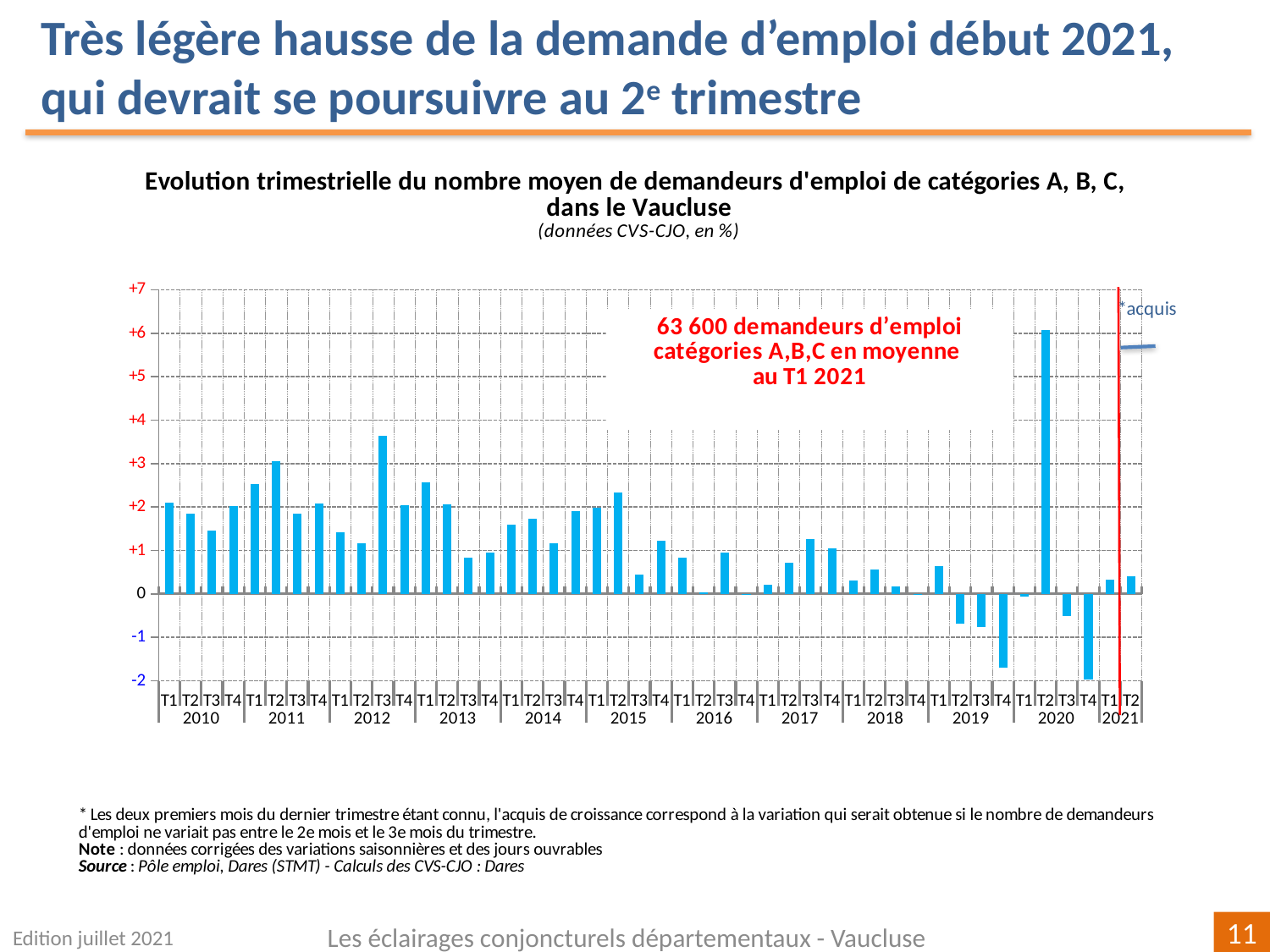
Which is larger, the value for T3 2012 or the value for T2 2011? T3 2012 Is the value for T1 2011 greater or less than +2? greater Is the value for T4 2019 greater or less than -1? less Is the value for T2 2020 greater or less than +5? greater According to the annotation on the chart, how many demandeurs d'emploi catégories A,B,C were there on average in T1 2021? 63 600 What kind of chart is shown on the slide? bar chart Do the values rise or fall from T1 2019 to T4 2019? fall How many years are labelled on the x axis of the chart? 12 Which quarter has the highest value in the chart? T2 2020 Which quarter has the lowest value in the chart? T4 2020